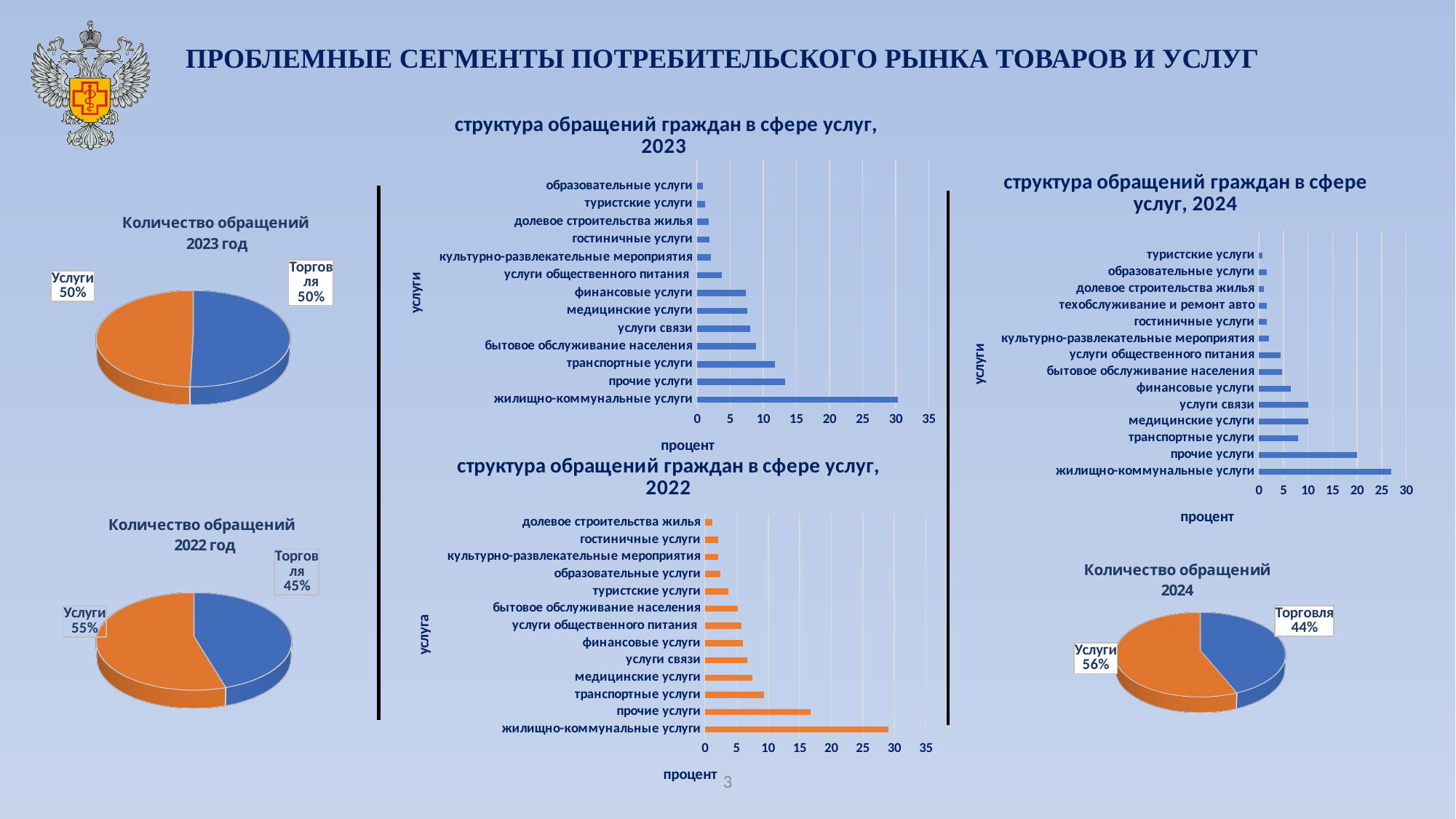
In the pie chart 'Количество обращений 2023 год', what share is labelled for Услуги? 50% In the pie chart 'Количество обращений 2022 год', what is the value shown for Торговля? 45% In the chart 'структура обращений граждан в сфере услуг, 2023', which category has the highest value? жилищно-коммунальные услуги In the chart 'структура обращений граждан в сфере услуг, 2023', which category has the lowest value? образовательные услуги In the pie chart 'Количество обращений 2022 год', which slice is larger, Услуги or Торговля? Услуги In the chart 'структура обращений граждан в сфере услуг, 2023', is the value for жилищно-коммунальные услуги greater or less than 25? greater In the chart 'структура обращений граждан в сфере услуг, 2022', is the value for прочие услуги greater or less than 15? greater In the pie chart 'Количество обращений 2024', what is the difference between the Услуги and Торговля shares? 12% What type of chart is 'структура обращений граждан в сфере услуг, 2024'? bar chart In the pie chart 'Количество обращений 2024', what is the value shown for Услуги? 56% In the chart 'структура обращений граждан в сфере услуг, 2024', which category has the lowest value? туристские услуги In the chart 'структура обращений граждан в сфере услуг, 2022', how many categories are plotted? 13